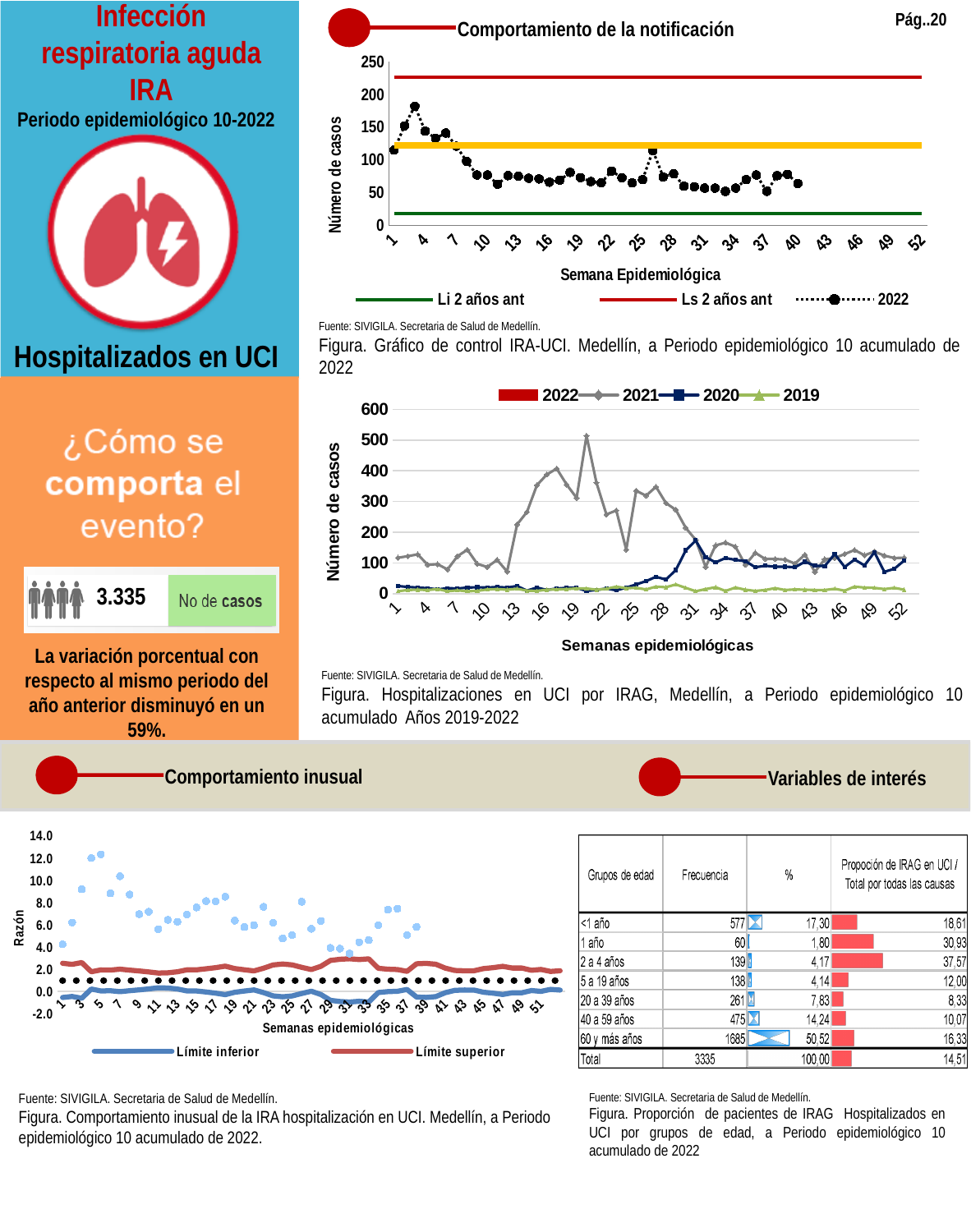
In the 'Hospitalizaciones en UCI por IRAG' chart, which year's series reaches the highest value? 2021 In the 'Comportamiento de la notificación' chart, what is the label of the x axis? Semana Epidemiológica In the 'Hospitalizaciones en UCI por IRAG' chart, how many series does the legend list? 4 In the 'Hospitalizaciones en UCI por IRAG' chart, is the 2019 series at week 19 greater or less than 100? less In the 'Comportamiento de la notificación' chart, is the 'Ls 2 años ant' line greater or less than 200? greater In the 'Comportamiento inusual' chart at the bottom left, how many series does the legend list? 2 What kind of chart is the 'Comportamiento de la notificación' chart at the top right? line chart In the 'Comportamiento de la notificación' chart, is the 2022 value at week 3 greater or less than 150? greater In the 'Comportamiento de la notificación' chart, how many series does the legend list? 3